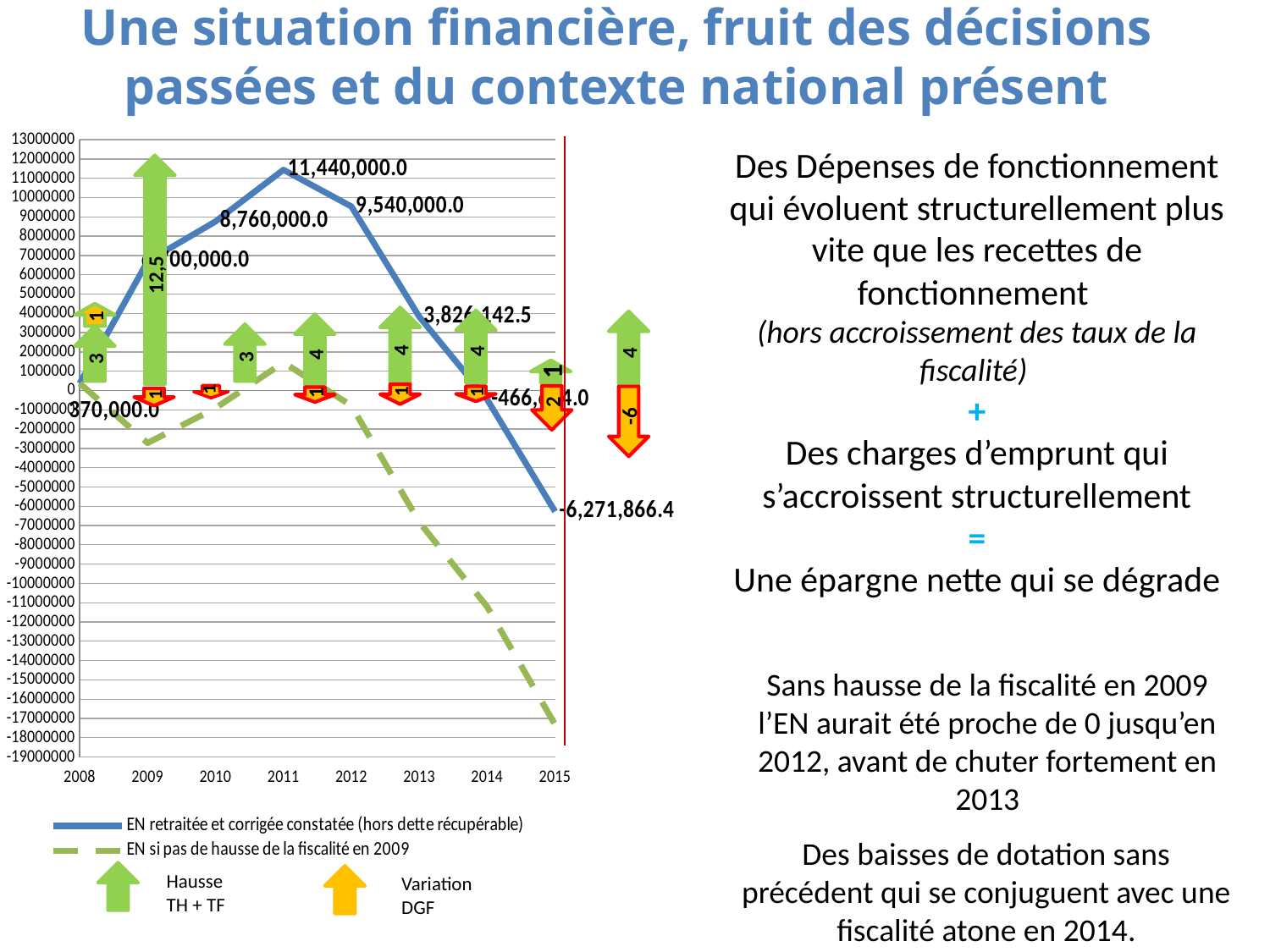
In which year does the 'EN retraitée et corrigée constatée' line reach its highest value? 2011 What kind of chart is shown on the slide? line chart In which year does the 'EN retraitée et corrigée constatée' line reach its lowest value? 2015 How many years are shown on the x axis of the chart? 8 What is the value of the 'EN retraitée et corrigée constatée' line in 2012? 9,540,000.0 How many line series does the chart legend list? 2 Which year has the larger value on the 'EN retraitée et corrigée constatée' line, 2010 or 2012? 2012 What is the value of the 'EN retraitée et corrigée constatée' line in 2011? 11,440,000.0 Does the 'EN retraitée et corrigée constatée' line rise or fall from 2011 to 2015? fall What is the value of the 'EN retraitée et corrigée constatée' line in 2015? -6,271,866.4 What is the difference between the 2011 and 2012 values of the 'EN retraitée et corrigée constatée' line? 1,900,000.0 What is the value of the 'EN retraitée et corrigée constatée' line in 2010? 8,760,000.0